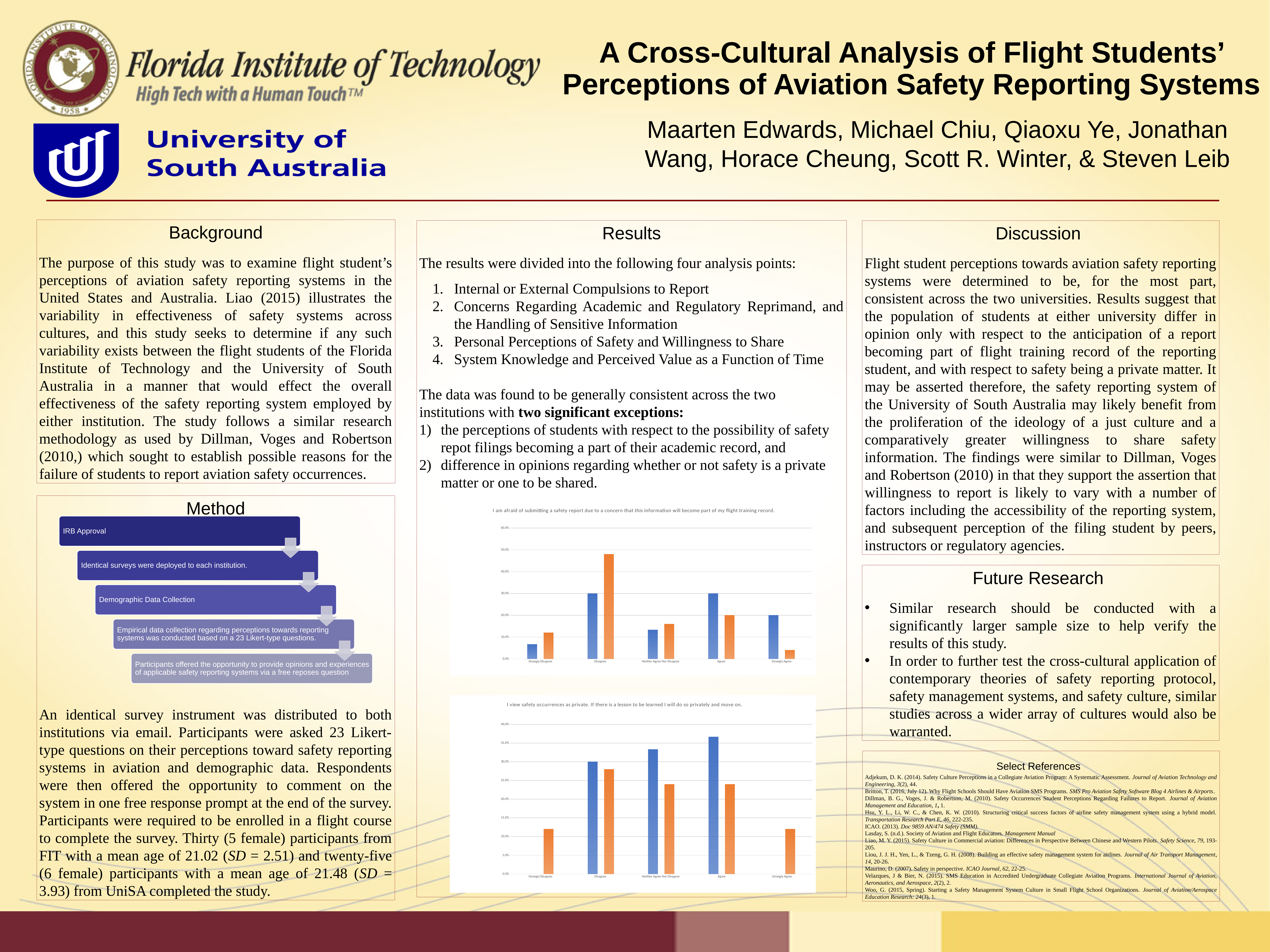
In the bottom chart in the Results section, which response category has the highest blue bar? Agree In the bottom chart in the Results section, is the orange bar for Strongly Agree greater or less than 15.0%? less In the top chart in the Results section, for the Disagree category, which bar is taller, the blue one or the orange one? orange In the top chart in the Results section, for the Strongly Agree category, which bar is taller, the blue one or the orange one? blue What kind of chart is the top chart in the Results section, titled "I am afraid of submitting a safety report due to a concern that this information will become part of my flight training record"? bar chart In the top chart in the Results section, is the blue bar for Strongly Disagree greater or less than 10.0%? less In the top chart in the Results section, is the orange bar for Disagree greater or less than 40.0%? greater What kind of chart is the bottom chart in the Results section, titled "I view safety occurrences as private. If there is a lesson to be learned I will do so privately and move on"? bar chart In the bottom chart in the Results section, for the Neither Agree Nor Disagree category, which bar is taller, the blue one or the orange one? blue How many response categories are shown on the x axis of the top chart in the Results section? 5 In the top chart in the Results section, which response category has the highest orange bar? Disagree